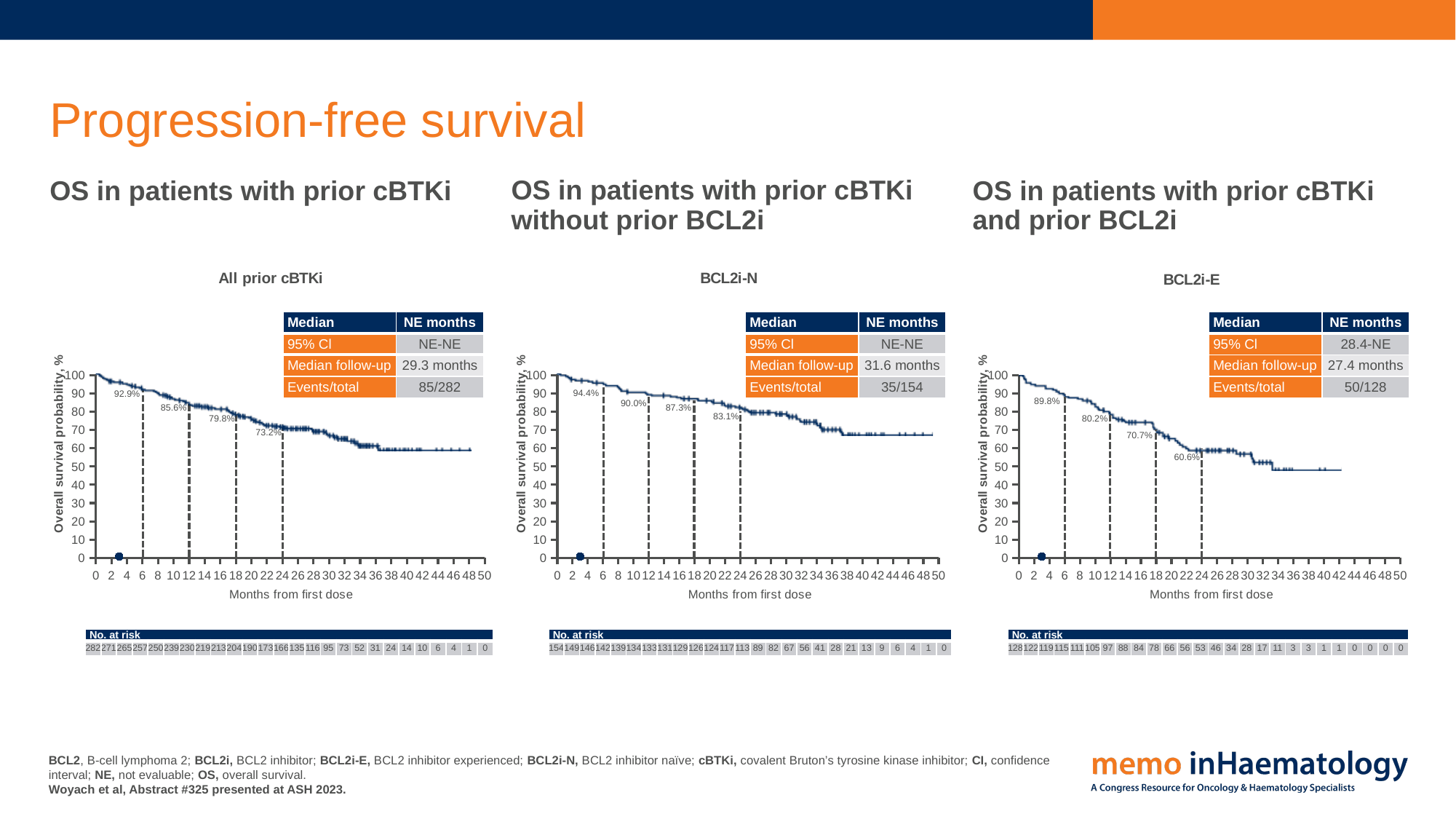
Which chart shows the higher labelled survival probability at 18 months, 'BCL2i-N' or 'BCL2i-E'? BCL2i-N In the 'All prior cBTKi' chart, is the survival probability at 40 months greater or less than 50? greater In the 'All prior cBTKi' chart, what is the overall survival probability labelled at the 6-month dashed line? 92.9% In the 'BCL2i-N' chart, what is the Events/total value shown in the table? 35/154 In the 'BCL2i-N' chart, what is the overall survival probability labelled at the 12-month dashed line? 90.0% In the 'BCL2i-E' chart, what is the median follow-up shown in the table? 27.4 months In the 'BCL2i-E' chart, does the overall survival probability rise or fall as months from first dose increase? fall In the 'BCL2i-E' chart, what is the difference between the labelled survival probabilities at 6 months and 24 months? 29.2% In the 'All prior cBTKi' chart, what is the overall survival probability labelled at the 24-month dashed line? 73.2% In the 'BCL2i-E' chart, what is the overall survival probability labelled at the 24-month dashed line? 60.6% In the 'BCL2i-E' chart, what is the 95% CI shown in the table? 28.4-NE What kind of chart is used to show overall survival on this slide? Kaplan-Meier survival curve (line chart)